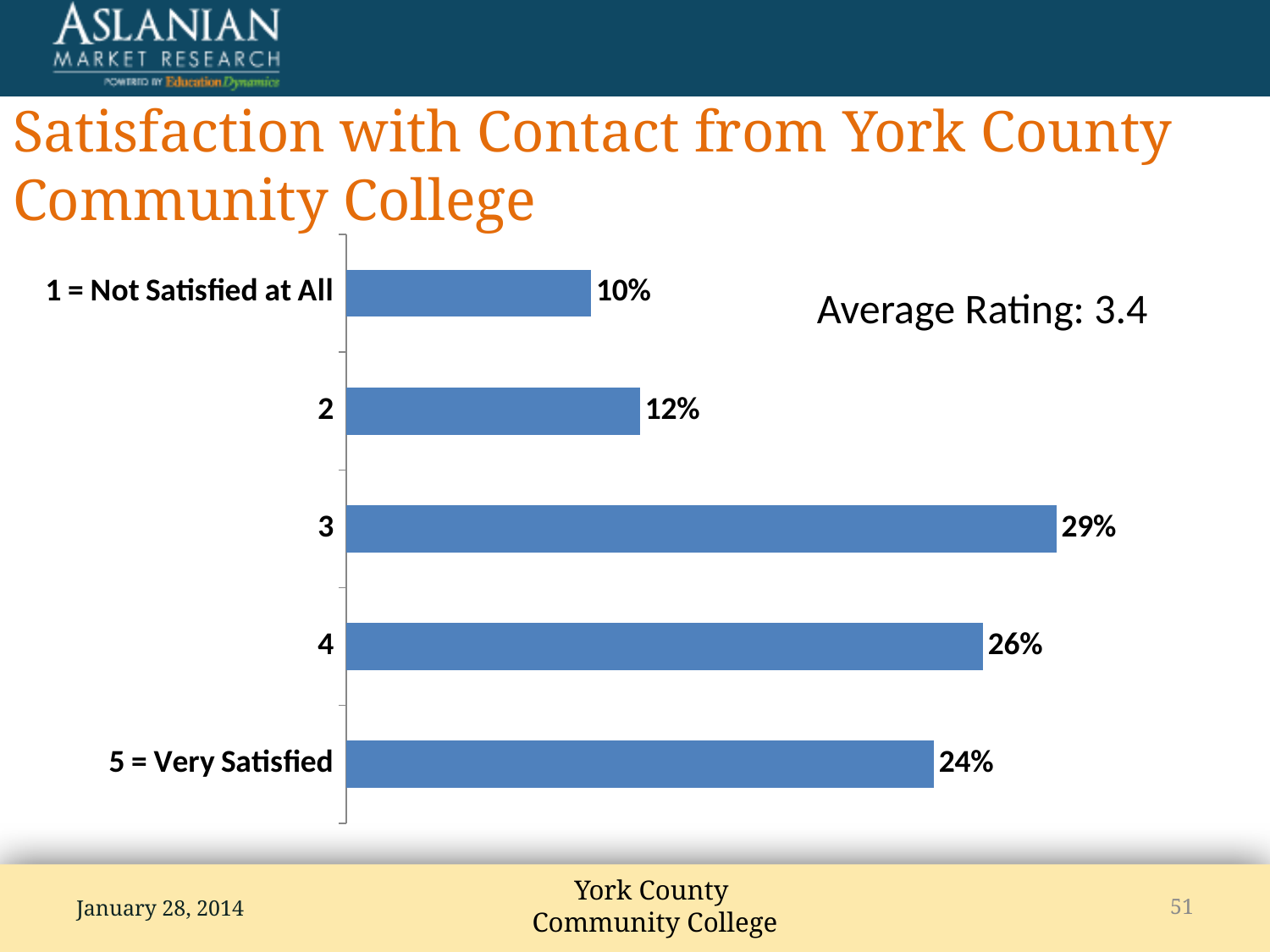
What percentage of respondents gave a rating of 3? 29% What is the difference in percentage points between rating 3 and rating 2? 17 How many rating categories are shown in the chart? 5 Which has a larger percentage, rating 4 or '5 = Very Satisfied'? 4 What is the average rating stated on the slide? 3.4 What type of chart is shown on the slide? Bar chart What percentage of respondents chose '1 = Not Satisfied at All'? 10% Which rating category has the lowest percentage? 1 = Not Satisfied at All What percentage of respondents gave a rating of 4? 26% Which rating category has the highest percentage? 3 What is the combined percentage of respondents who gave a rating of 4 or '5 = Very Satisfied'? 50% What percentage of respondents chose '5 = Very Satisfied'? 24%